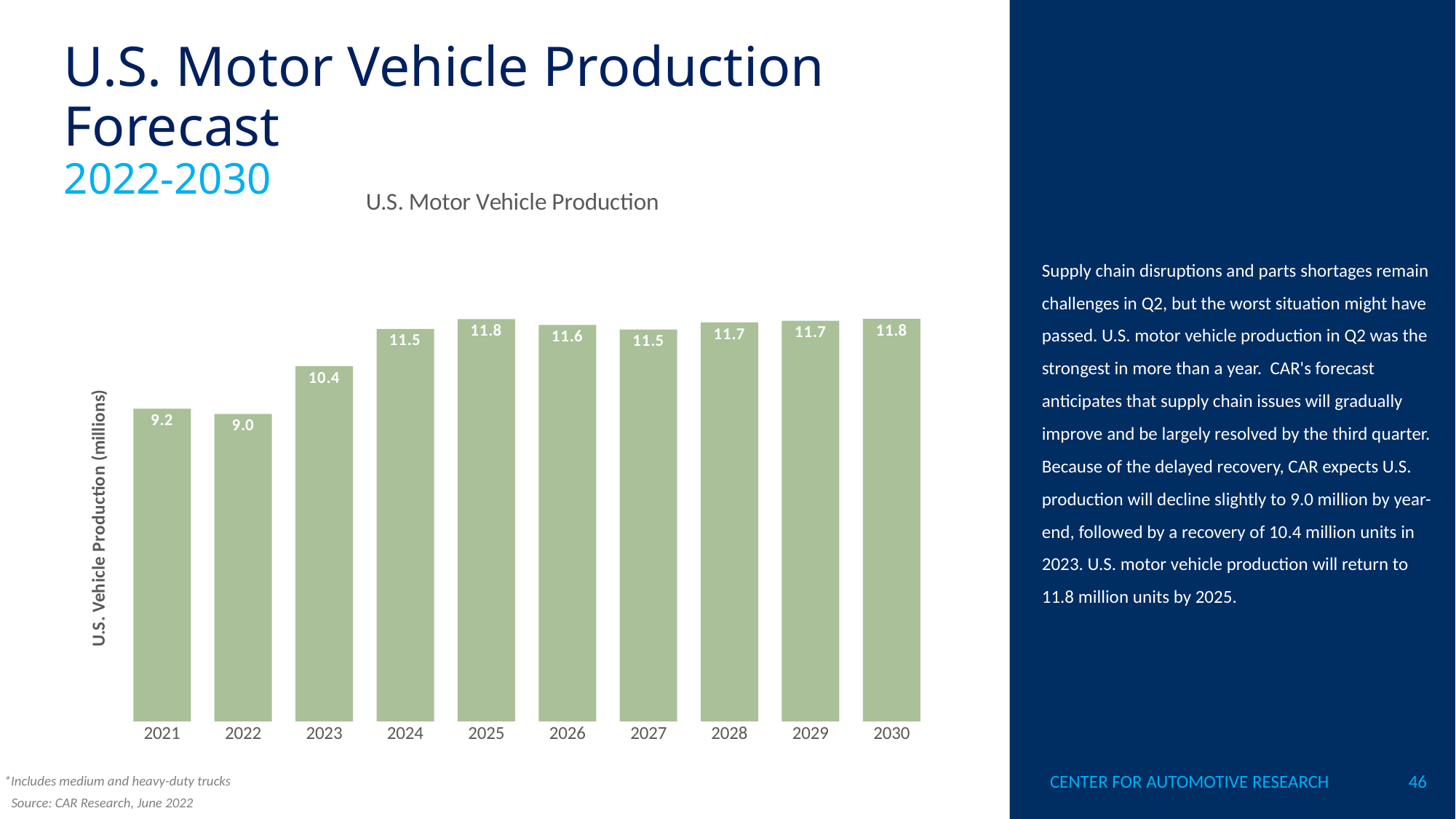
What is the value shown for 2028? 11.7 What type of chart is shown on the slide? Bar chart Which years share the highest value in the chart? 2025 and 2030 What is the label on the vertical axis of the chart? U.S. Vehicle Production (millions) Which year has a larger value, 2021 or 2024? 2024 Do the values generally rise or fall from 2022 to 2025? Rise How many years are plotted in the chart? 10 What is the U.S. vehicle production value shown for 2023? 10.4 What is the difference between the values for 2023 and 2022? 1.4 What is the value shown for 2022 in the U.S. Motor Vehicle Production chart? 9.0 Which year has the lowest U.S. vehicle production value in the chart? 2022 What is the difference between the values for 2025 and 2021? 2.6